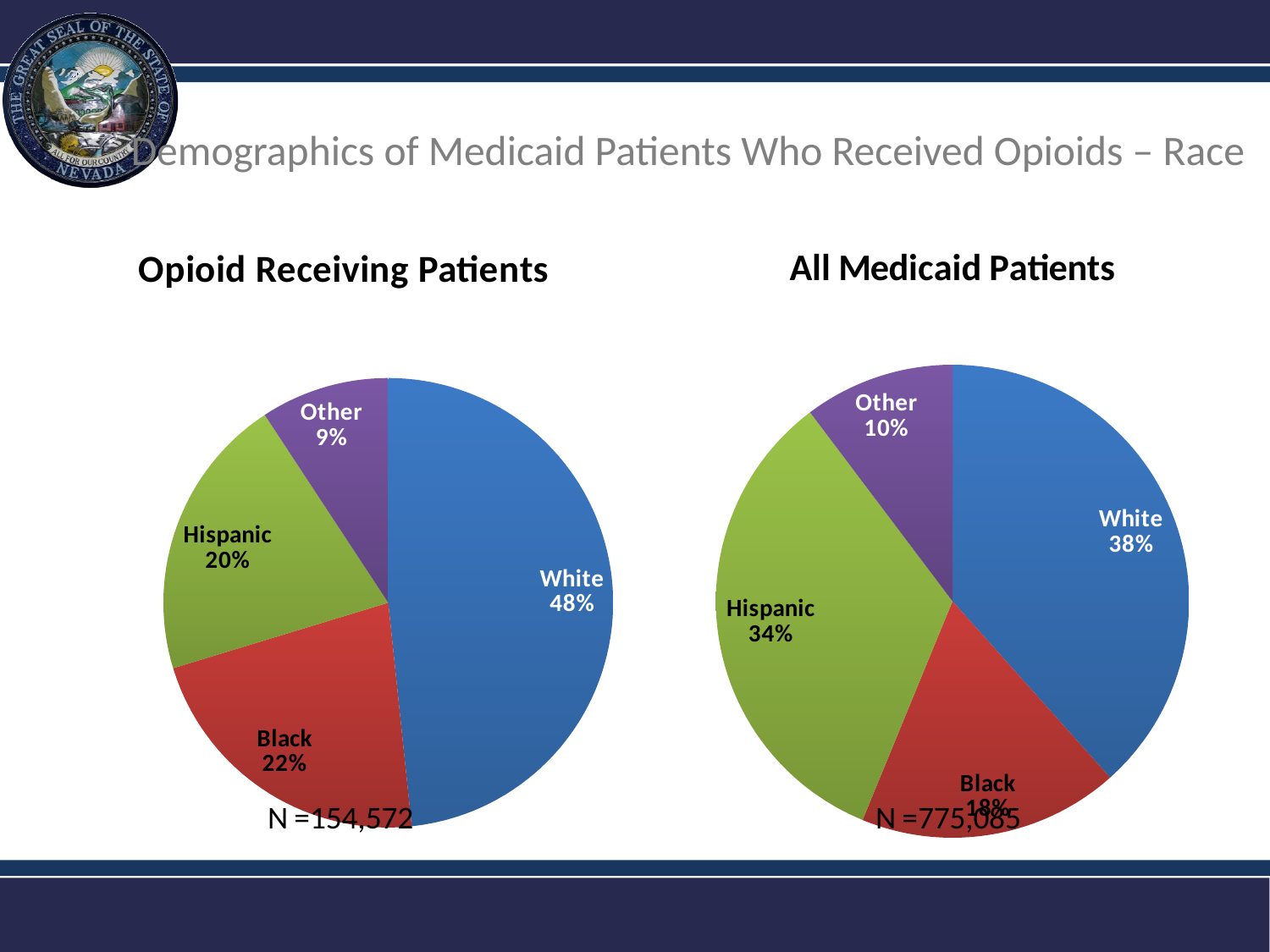
In the 'All Medicaid Patients' chart, what share of the pie is Hispanic? 34% In the 'Opioid Receiving Patients' chart, which category has the largest slice? White What is the difference between the White share in the 'Opioid Receiving Patients' chart and the White share in the 'All Medicaid Patients' chart? 10% In the 'All Medicaid Patients' chart, what share of the pie is Other? 10% In the 'Opioid Receiving Patients' chart, what share of the pie is Hispanic? 20% How many categories does the 'All Medicaid Patients' pie chart show? 4 What kind of chart is the 'Opioid Receiving Patients' chart? Pie chart In the 'Opioid Receiving Patients' chart, which category has the smallest slice? Other In the 'All Medicaid Patients' chart, which is larger, the White slice or the Hispanic slice? White